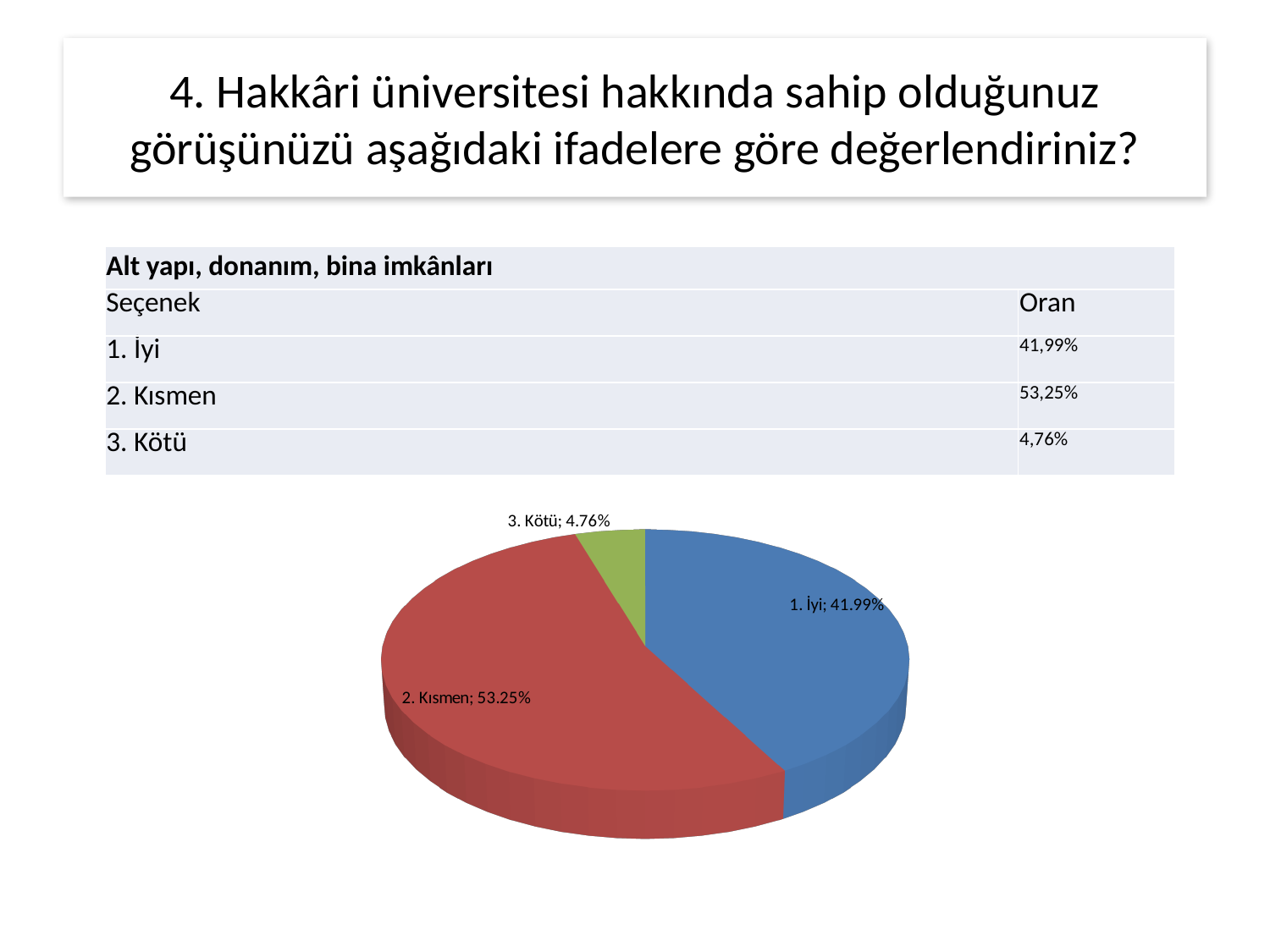
How many slices does the pie chart have? 3 What colour is the slice for "2. Kısmen" in the pie chart? Red What kind of chart is shown on the slide? Pie chart Which slice of the pie chart is the smallest? 3. Kötü Which slice of the pie chart is the largest? 2. Kısmen What is the value shown for the slice labelled "1. İyi" in the pie chart? 41.99% What is the difference between the values for "1. İyi" and "3. Kötü" in the pie chart? 37.23% What is the difference between the values for "2. Kısmen" and "1. İyi" in the pie chart? 11.26% Which is larger in the pie chart, the slice for "1. İyi" or the slice for "2. Kısmen"? 2. Kısmen What is the value shown for the slice labelled "3. Kötü" in the pie chart? 4.76% What colour is the slice for "3. Kötü" in the pie chart? Green What is the value shown for the slice labelled "2. Kısmen" in the pie chart? 53.25%